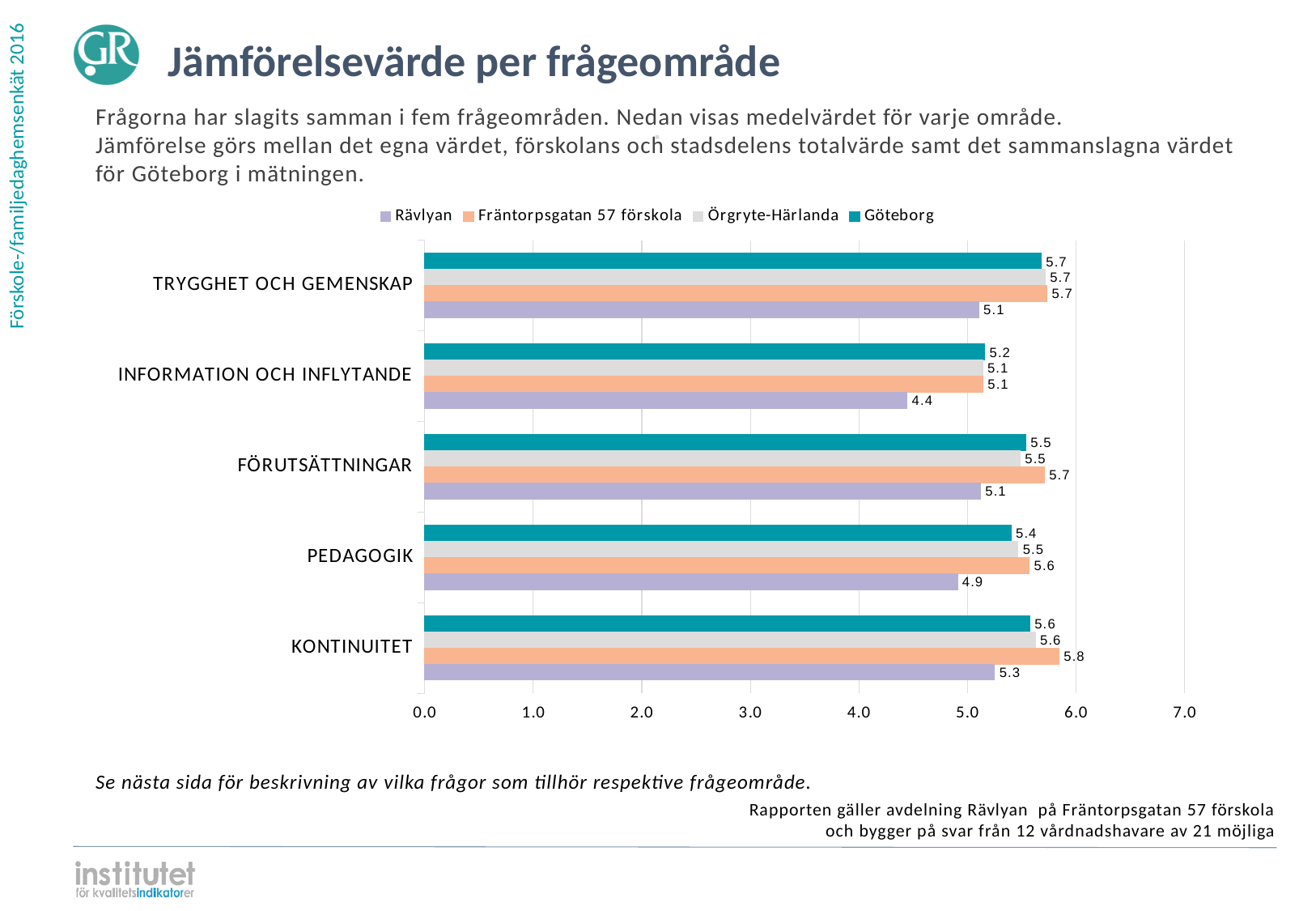
In which category does Rävlyan have its highest value? KONTINUITET What is the difference between the Fräntorpsgatan 57 förskola value and the Rävlyan value in the PEDAGOGIK category? 0.7 Is the value for Rävlyan in the KONTINUITET category greater or less than 5.0? greater How many series does the legend list? 4 What is the value for Rävlyan in the INFORMATION OCH INFLYTANDE category? 4.4 Which is larger in the TRYGGHET OCH GEMENSKAP category: the value for Göteborg or the value for Rävlyan? Göteborg In which category does Rävlyan have its lowest value? INFORMATION OCH INFLYTANDE What is the value for Örgryte-Härlanda in the FÖRUTSÄTTNINGAR category? 5.5 How many categories are shown on the chart? 5 What is the value for Fräntorpsgatan 57 förskola in the KONTINUITET category? 5.8 What is the value for Göteborg in the PEDAGOGIK category? 5.4 What kind of chart is shown on the slide? Bar chart